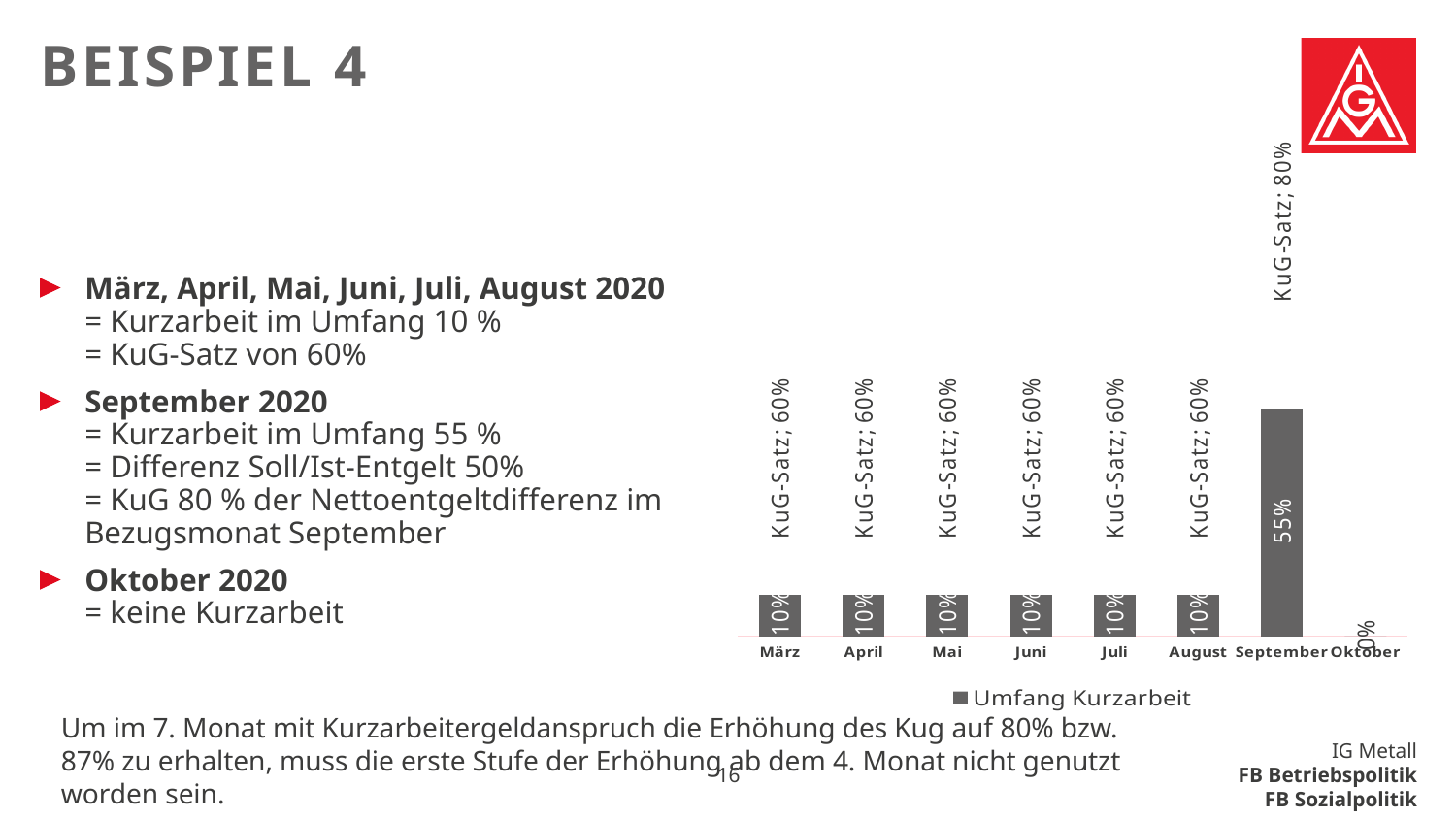
What is the value for Oktober in the chart? 0% Which is larger, the value for September or the value for Juli? September What is the value for März in the chart? 10% How many series does the chart legend list? 1 What kind of chart is shown on the slide? bar chart Which month has the lowest value in the chart? Oktober Which month has the highest value in the chart? September What is the difference between the values for September and August? 45% What is the value for September in the chart? 55% What is the name of the series shown in the chart legend? Umfang Kurzarbeit How many months are shown on the x axis of the chart? 8 What KuG-Satz is labelled above the September bar? KuG-Satz; 80%